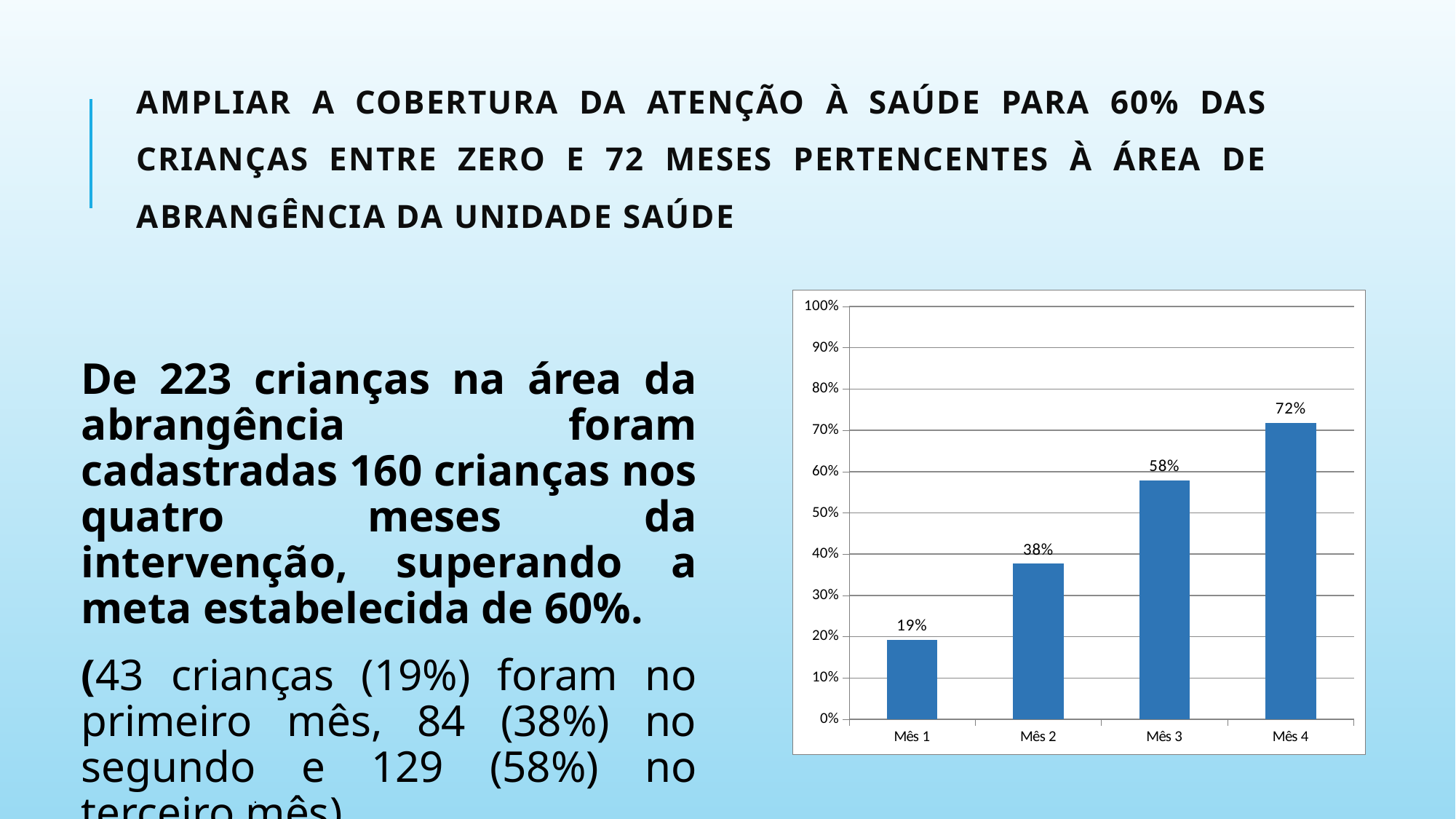
What is the value for Mês 1? 19% Which is larger, the value for Mês 2 or the value for Mês 3? Mês 3 Is the value for Mês 4 greater or less than 60%? greater What is the difference between the values for Mês 3 and Mês 2? 20% What is the value for Mês 2? 38% What kind of chart is shown on the slide? bar chart What is the value for Mês 3? 58% Which month has the highest value? Mês 4 What is the difference between the values for Mês 4 and Mês 1? 53% What is the value for Mês 4? 72% Which month has the lowest value? Mês 1 How many months are shown on the x axis of the chart? 4